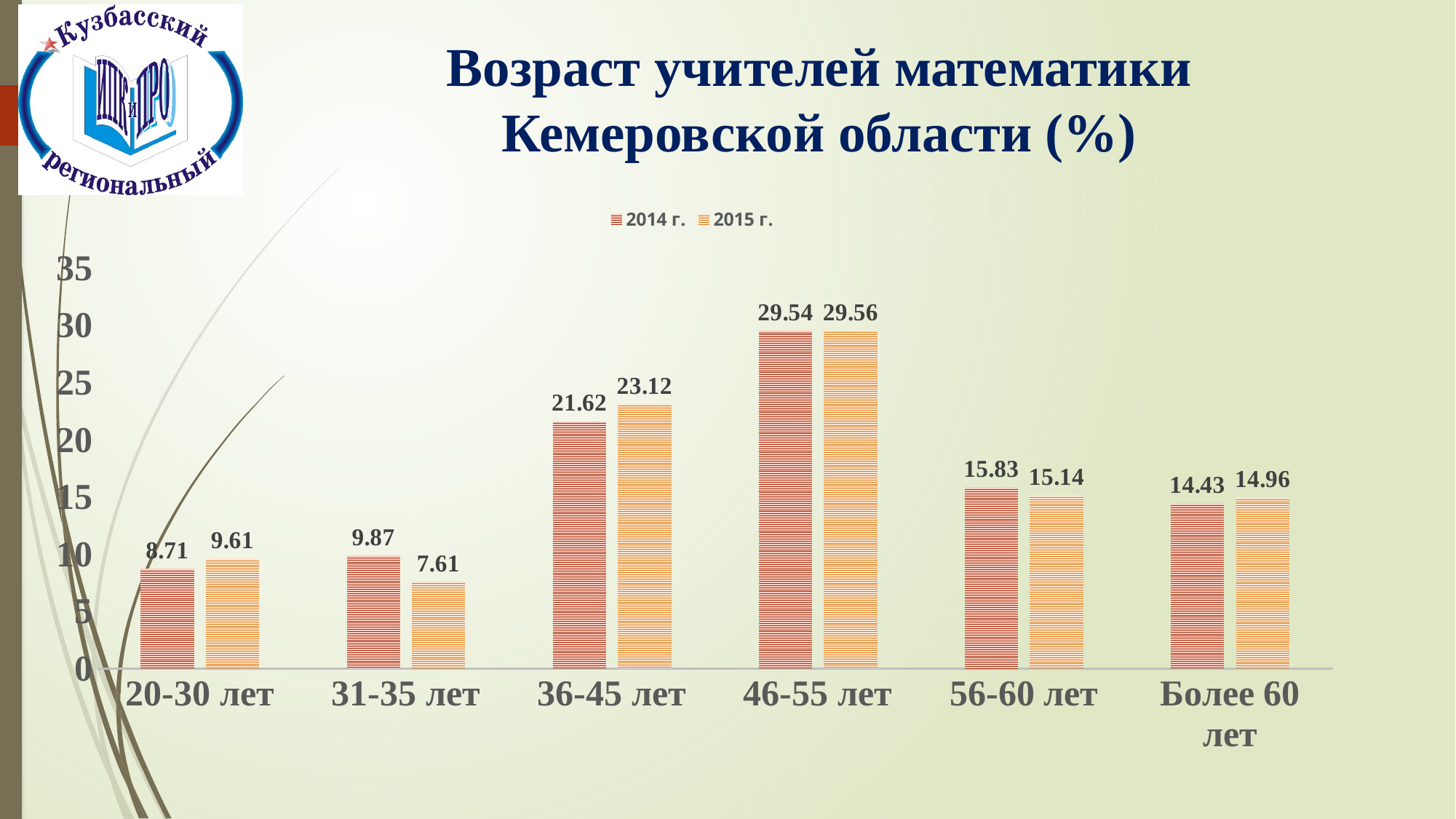
How many series does the legend list? 2 What is the title of the chart? Возраст учителей математики Кемеровской области (%) What is the value for 2015 г. in the Более 60 лет category? 14.96 How many age categories are shown on the x axis? 6 Which age category has the highest value for 2014 г.? 46-55 лет What is the difference between the 2015 г. and 2014 г. values for 36-45 лет? 1.50 Which age category has the lowest value for 2015 г.? 31-35 лет Which is larger for 56-60 лет: the 2014 г. value or the 2015 г. value? 2014 г. What is the value for 2015 г. in the 31-35 лет category? 7.61 What is the value for 2014 г. in the 36-45 лет category? 21.62 What is the difference between the 2014 г. and 2015 г. values for 31-35 лет? 2.26 What kind of chart is shown on the slide? Bar chart